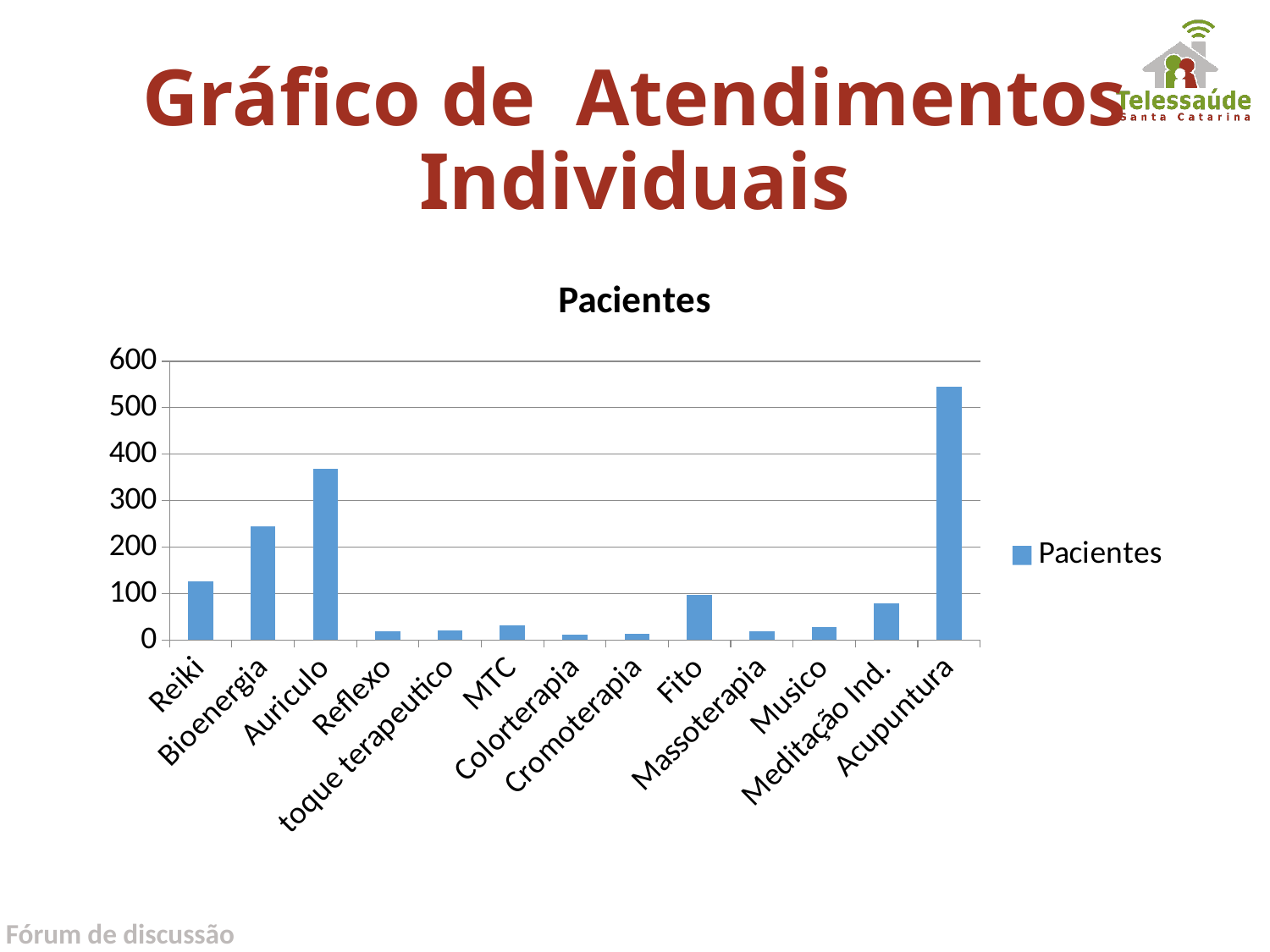
What is the title of the chart? Pacientes Is the value for Meditação Ind. greater or less than 100? less Which is larger, the value for Fito or the value for Reiki? Reiki Is the value for Auriculo greater or less than 300? greater Is the value for Acupuntura greater or less than 500? greater Which is larger, the value for Auriculo or the value for Bioenergia? Auriculo Which category has the highest value? Acupuntura How many series does the legend list? 1 How many categories are shown on the x axis of the chart? 13 What kind of chart is shown on the slide? bar chart